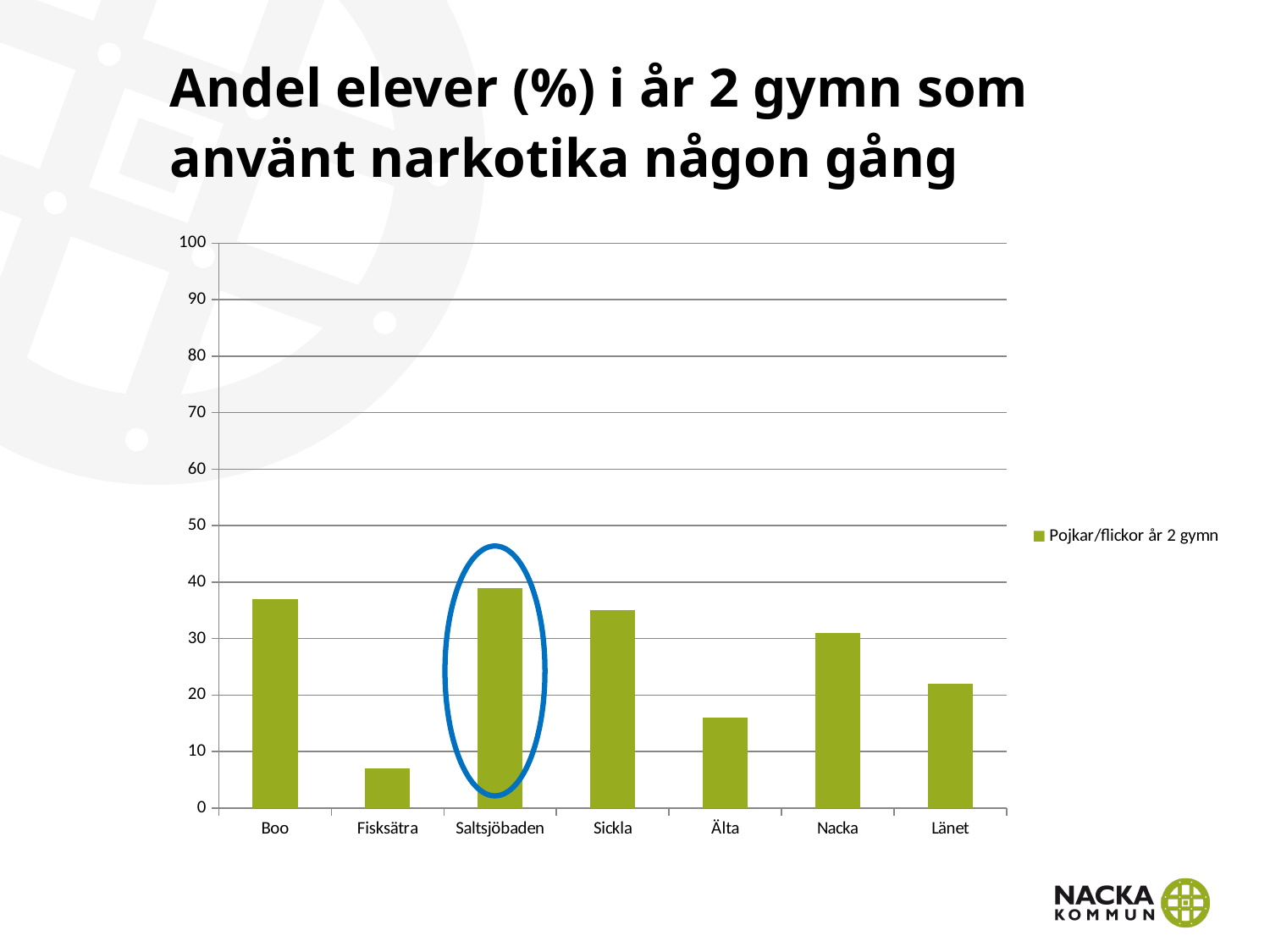
What is the legend entry for the series shown? Pojkar/flickor år 2 gymn How many series does the legend list? 1 Is the value for Älta greater or less than 20? less Is the value for Sickla greater or less than 30? greater Which is larger, the value for Älta or the value for Länet? Länet Which category has the lowest value? Fisksätra Which category has the highest value? Saltsjöbaden Is the value for Boo greater or less than 30? greater Which is larger, the value for Boo or the value for Nacka? Boo How many categories are shown on the x axis? 7 What kind of chart is shown on the slide? bar chart